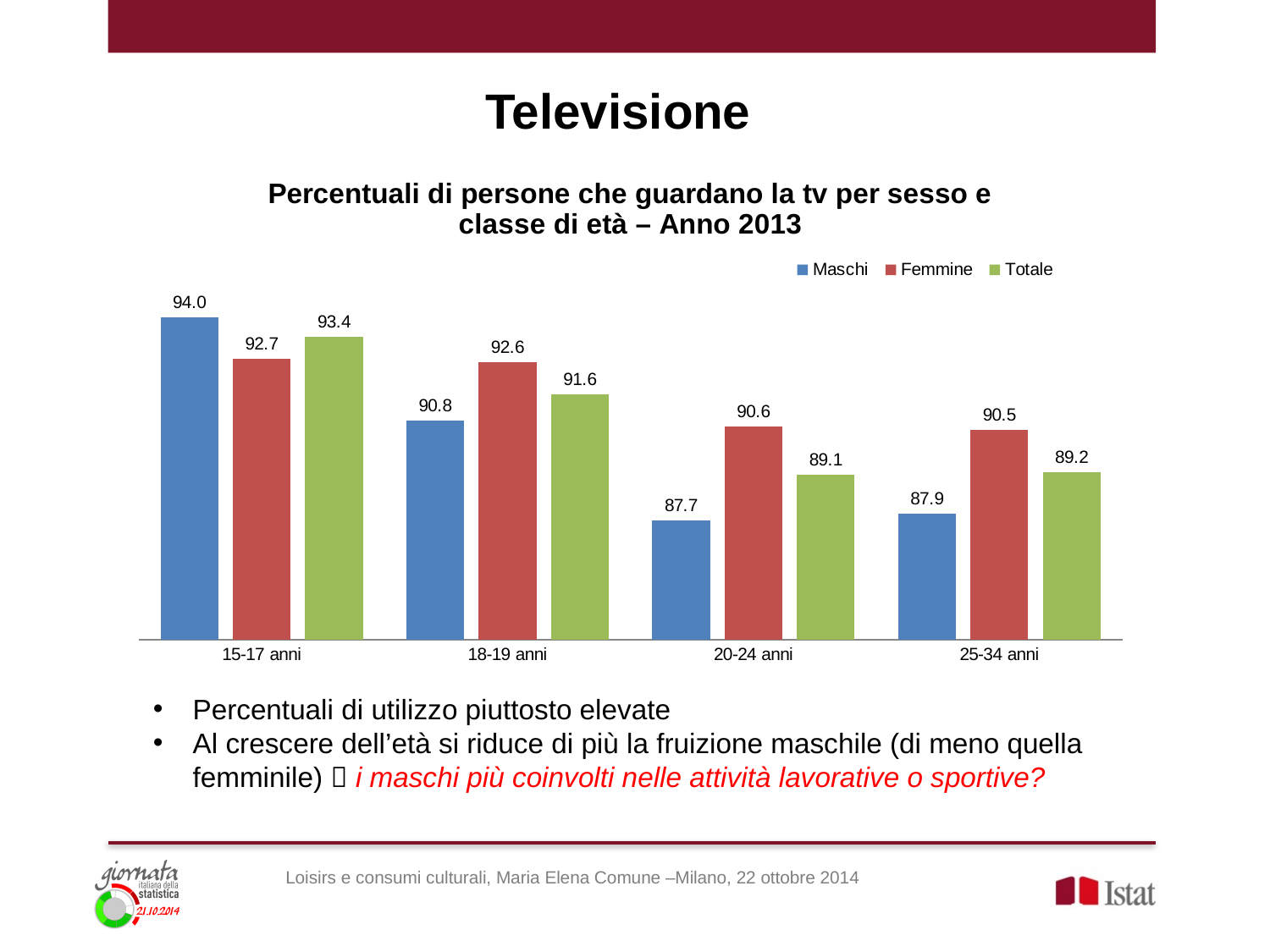
How many age groups are shown on the x axis? 4 What is the value for Maschi in the 15-17 anni age group? 94.0 Which is larger in the 18-19 anni age group, the Maschi value or the Femmine value? Femmine What is the value for Totale in the 25-34 anni age group? 89.2 Does the Maschi value rise or fall from 15-17 anni to 20-24 anni? Fall What is the value for Femmine in the 20-24 anni age group? 90.6 Which age group has the lowest value for Totale? 20-24 anni Which age group has the highest value for Maschi? 15-17 anni What is the difference between the Femmine and Maschi values in the 20-24 anni age group? 2.9 How many series does the legend list? 3 Which colour represents the Totale series in the chart? Green What kind of chart is shown on the slide? Bar chart